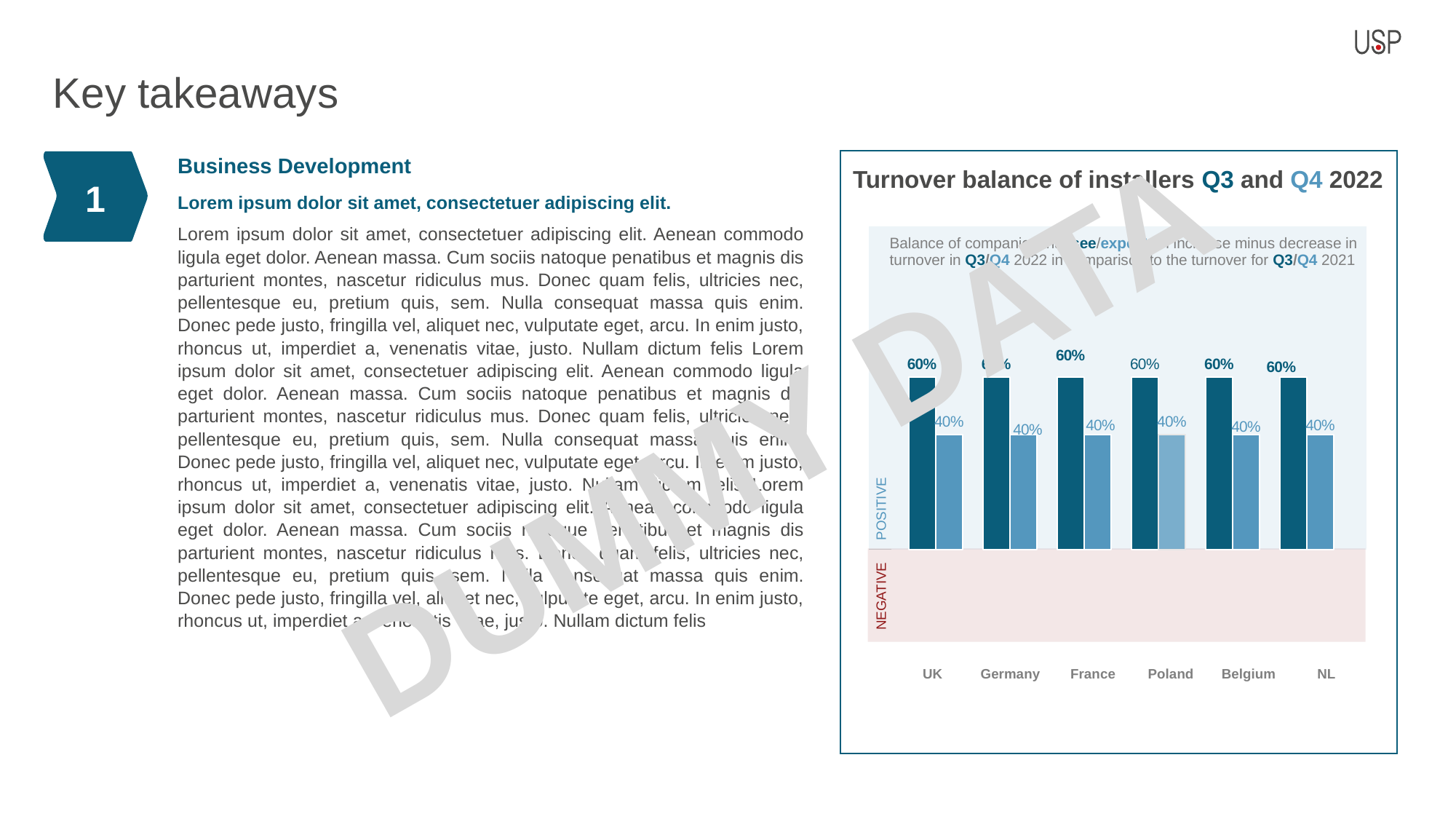
What type of chart is shown on the slide? Bar chart What is the Q4 2022 turnover balance value for France? 40% What is the Q4 2022 turnover balance value for Poland? 40% Which country is listed first on the x axis of the chart? UK What is the difference between the Q3 2022 and Q4 2022 values for the UK? 20 percentage points Which is larger for France: the Q3 2022 value or the Q4 2022 value? Q3 2022 What is the Q3 2022 turnover balance value for the UK? 60% What is the Q4 2022 turnover balance value for NL? 40% What is the title of the chart? Turnover balance of installers Q3 and Q4 2022 What is the Q3 2022 turnover balance value for Belgium? 60% Are all the plotted bars in the positive or the negative region of the chart? Positive How many countries are shown on the x axis of the chart? 6